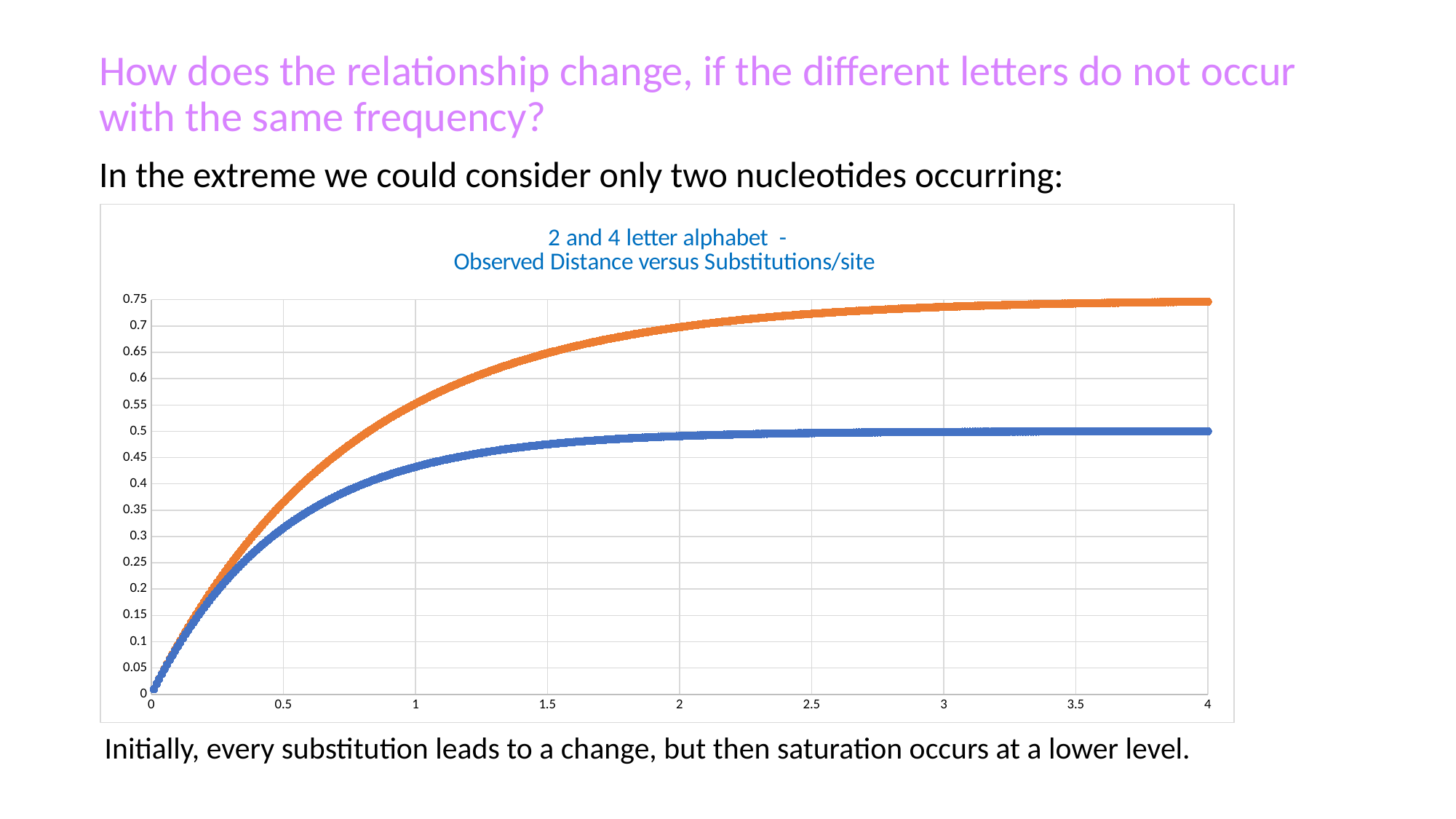
How many data series are plotted in the chart? 2 At x = 2, which series has the higher value, the orange series or the blue series? the orange series What is the highest value labelled on the y axis? 0.75 What kind of chart is shown on the slide? line chart What is the title of the chart? 2 and 4 letter alphabet - Observed Distance versus Substitutions/site At x = 3, is the value of the blue series greater or less than 0.45? greater At x = 1, is the value of the blue series greater or less than 0.5? less Do the values of the orange series rise or fall as the x axis increases? rise At x = 4, is the value of the blue series greater or less than 0.55? less Do the values of the blue series rise or fall as the x axis increases? rise